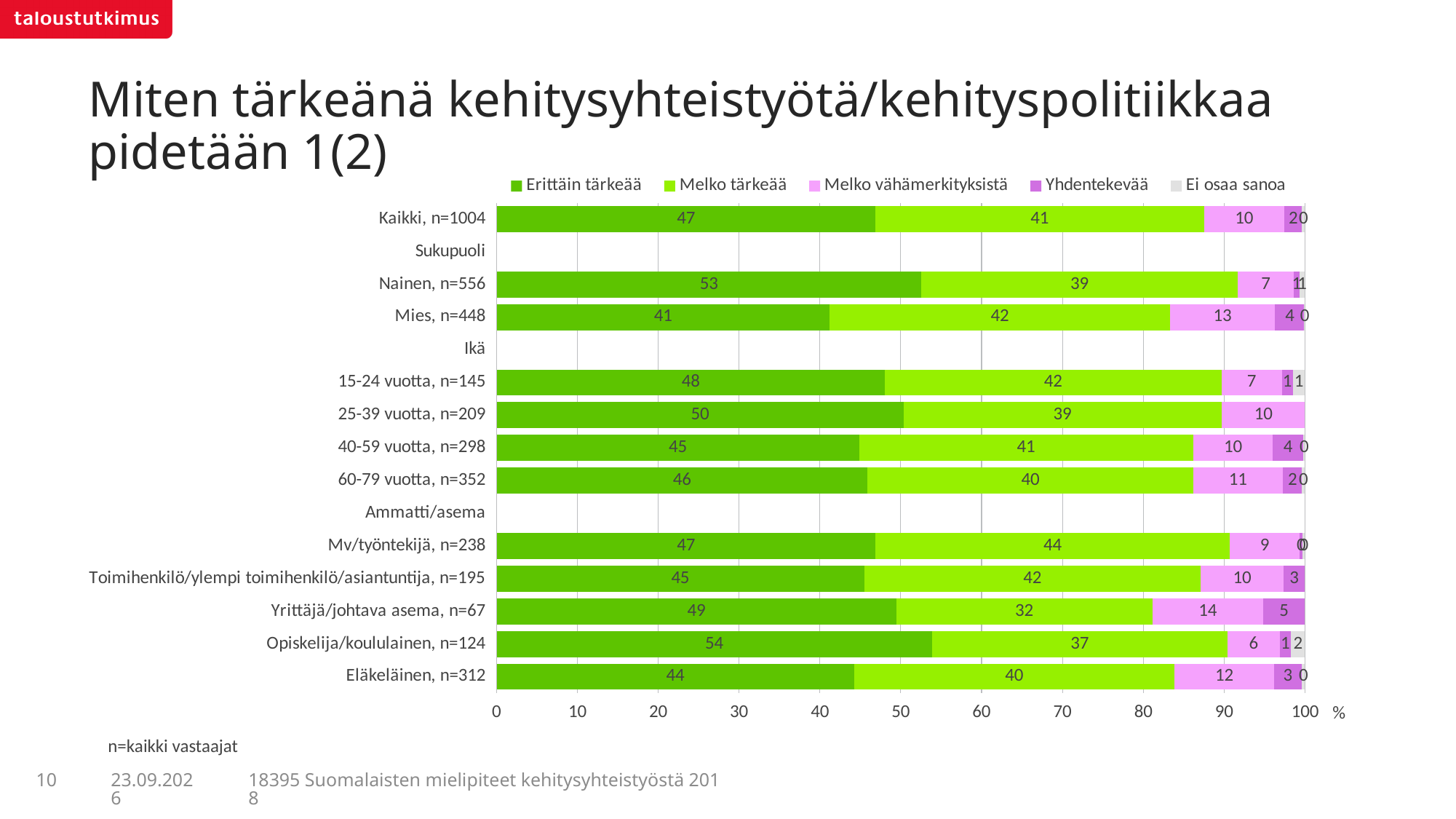
How many series does the legend list? 5 What percentage of all respondents (Kaikki, n=1004) answered "Erittäin tärkeää"? 47 Which has a larger "Melko tärkeää" value: Mv/työntekijä, n=238 or Eläkeläinen, n=312? Mv/työntekijä, n=238 How many groups have bars plotted in the chart? 12 Which group has the highest "Melko vähämerkityksistä" value? Yrittäjä/johtava asema, n=67 What is the "Melko tärkeää" value for Yrittäjä/johtava asema, n=67? 32 What is the "Yhdentekevää" value for 40-59 vuotta, n=298? 4 What is the "Melko vähämerkityksistä" value for Mies, n=448? 13 What kind of chart is shown on the slide? Stacked bar chart Which group has the lowest "Erittäin tärkeää" value? Mies, n=448 Which group has the highest "Erittäin tärkeää" value? Opiskelija/koululainen, n=124 What is the difference between the "Erittäin tärkeää" values for Nainen, n=556 and Mies, n=448? 12